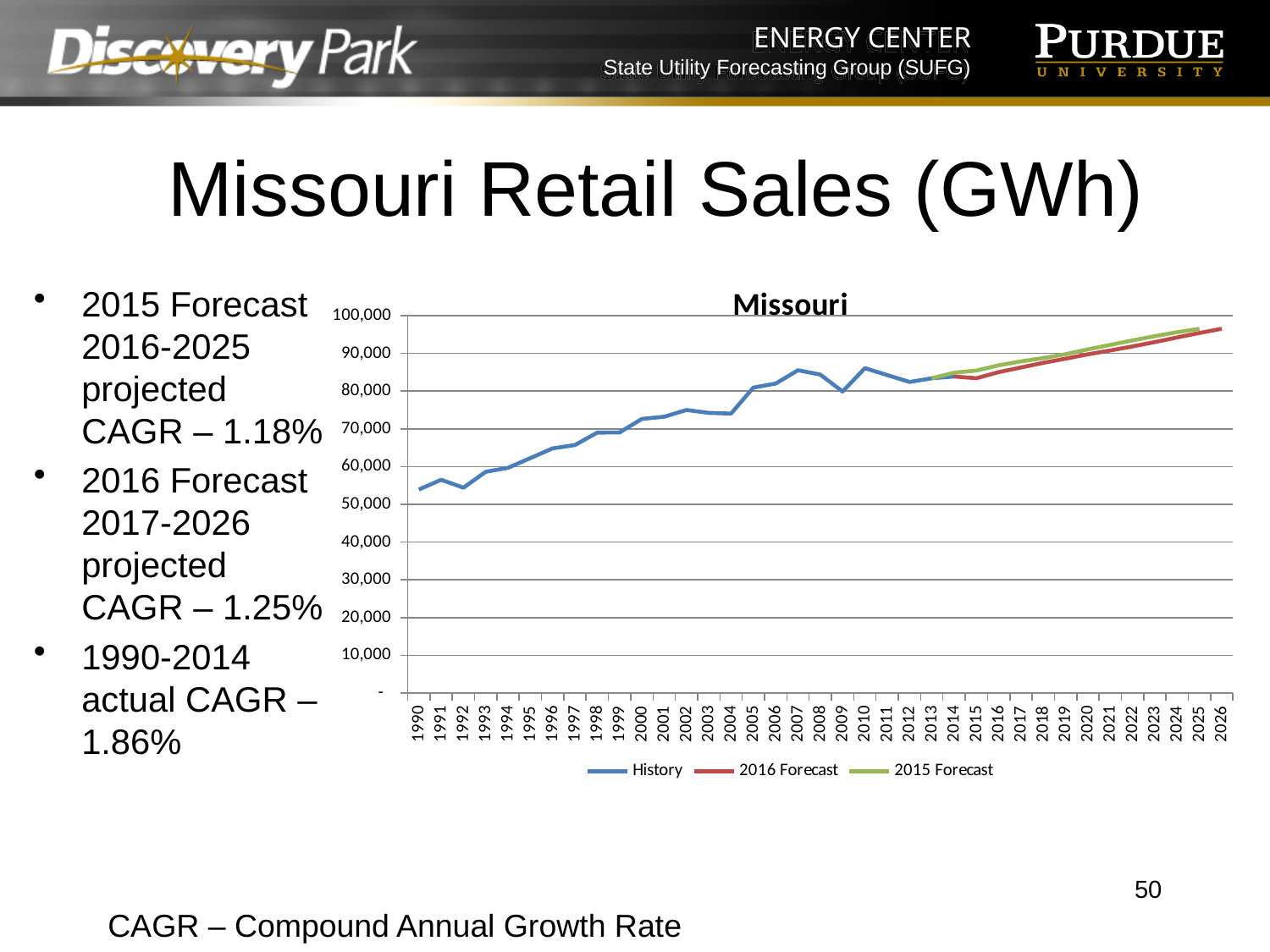
Is the 2016 Forecast value for 2026 greater or less than 90,000? greater Is the History value for 2007 greater or less than 80,000? greater How many series does the chart legend list? 3 In 2022, which series shows the higher value, 2015 Forecast or 2016 Forecast? 2015 Forecast What kind of chart is shown on the slide? Line chart How many years are labelled on the x axis of the chart? 37 What is the title of the chart? Missouri Is the 2015 Forecast value for 2025 greater or less than 90,000? greater Which series is drawn in blue on the chart? History Does the History series generally rise or fall from 1990 to 2014? Rise